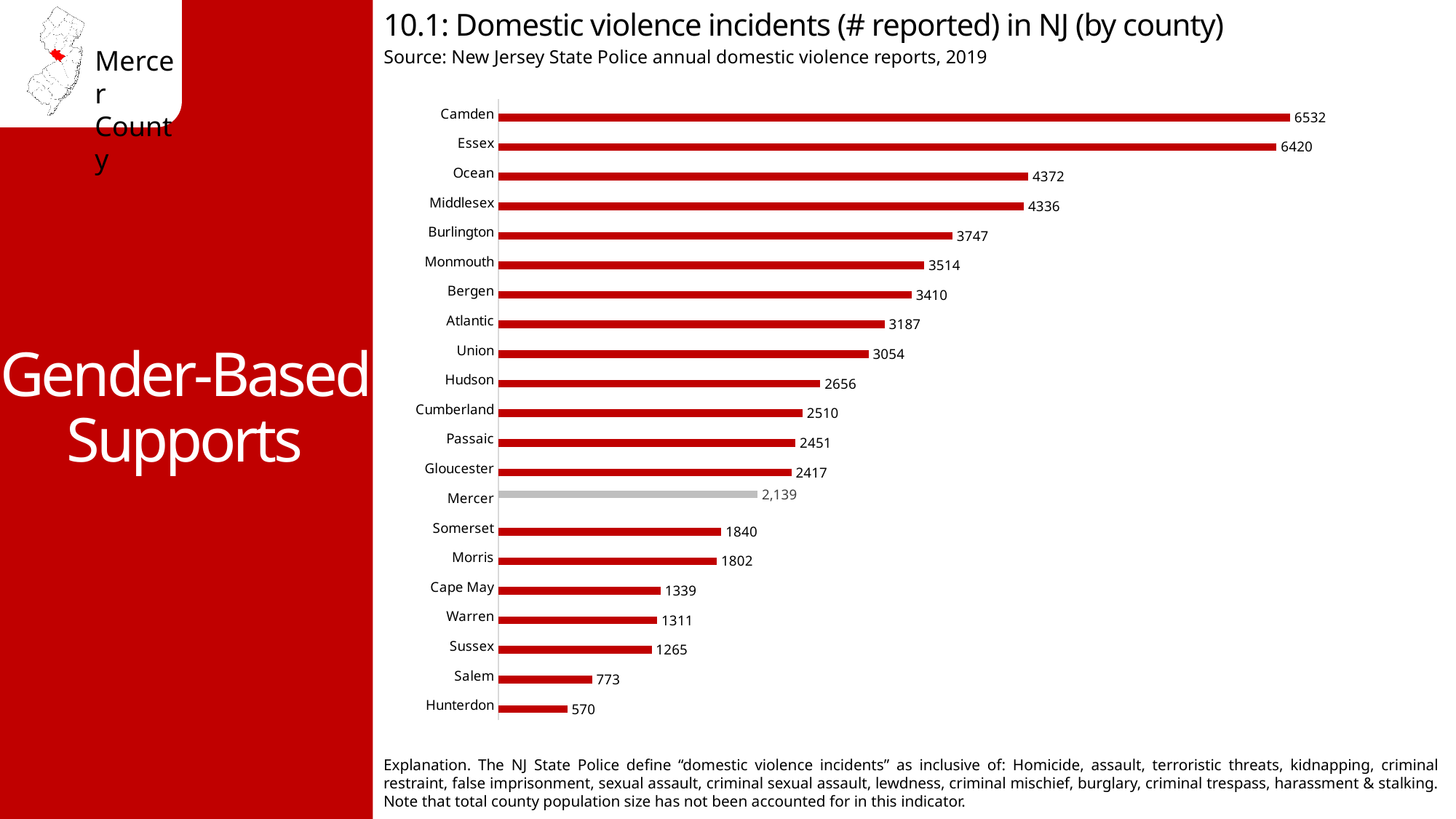
Which county has the lowest number of reported domestic violence incidents? Hunterdon How many counties are shown in the chart? 21 What is the difference between the values for Camden and Essex? 112 Which county has more reported incidents, Somerset or Morris? Somerset How many domestic violence incidents were reported in Mercer County? 2,139 Which county has the highest number of reported domestic violence incidents? Camden Which county's bar is shown in grey rather than red? Mercer How many domestic violence incidents were reported in Camden County? 6532 What is the value shown for Hunterdon? 570 What is the difference between the values for Gloucester and Mercer? 278 Which county has more reported incidents, Burlington or Monmouth? Burlington What kind of chart is shown on the slide? Bar chart